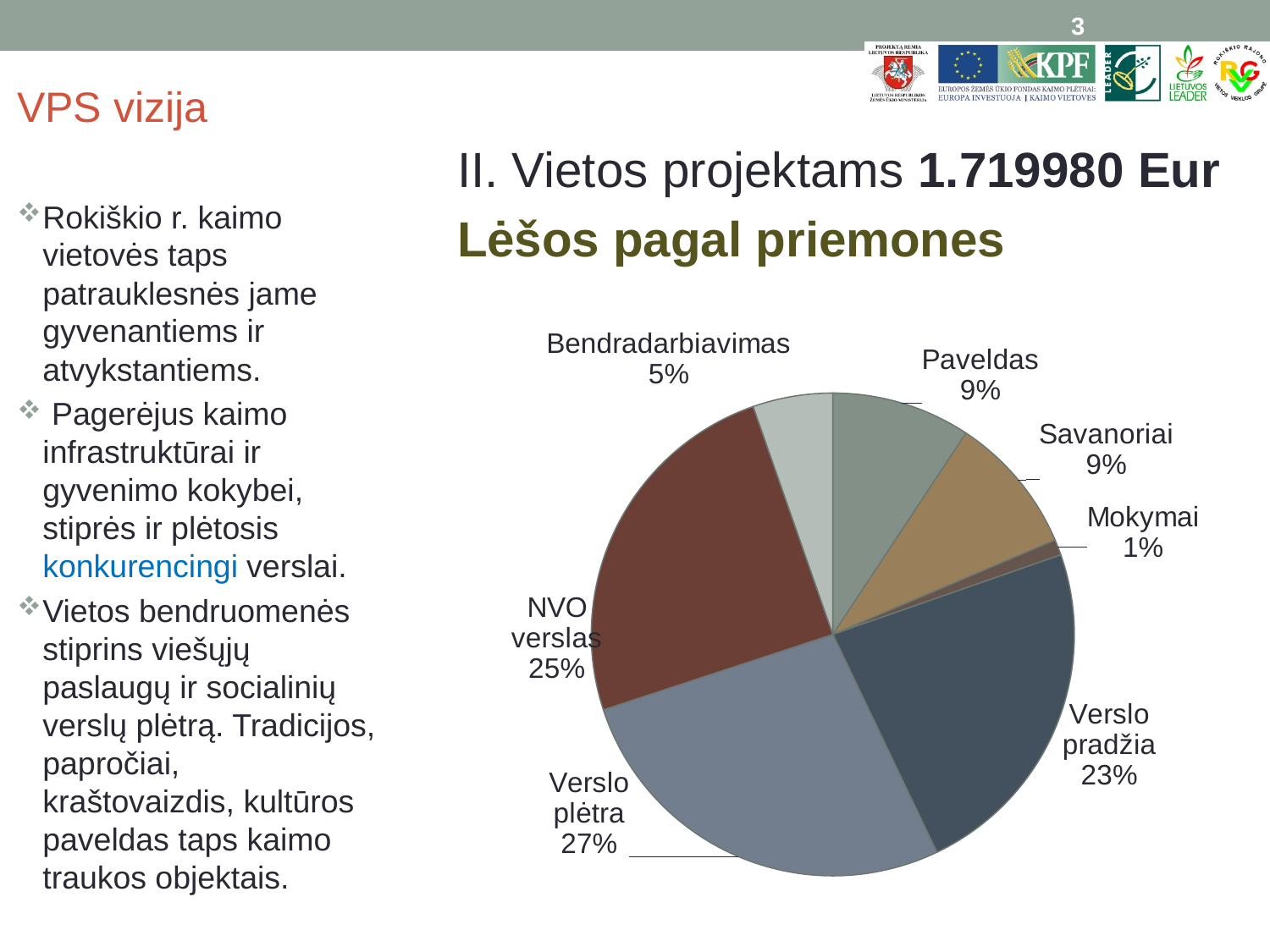
What is the difference between the shares of Verslo plėtra and Verslo pradžia? 4% What is the value shown for NVO verslas? 25% Which is larger, the share for NVO verslas or the share for Verslo pradžia? NVO verslas What share of the pie does Verslo plėtra have? 27% Which category has the largest slice of the pie? Verslo plėtra Which category has the smallest slice of the pie? Mokymai What is the value shown for Verslo pradžia? 23% What is the value shown for Mokymai? 1% What is the value shown for Bendradarbiavimas? 5% What kind of chart is shown on the slide? pie chart How many slices does the pie chart have? 7 What is the title of the chart? Lėšos pagal priemones